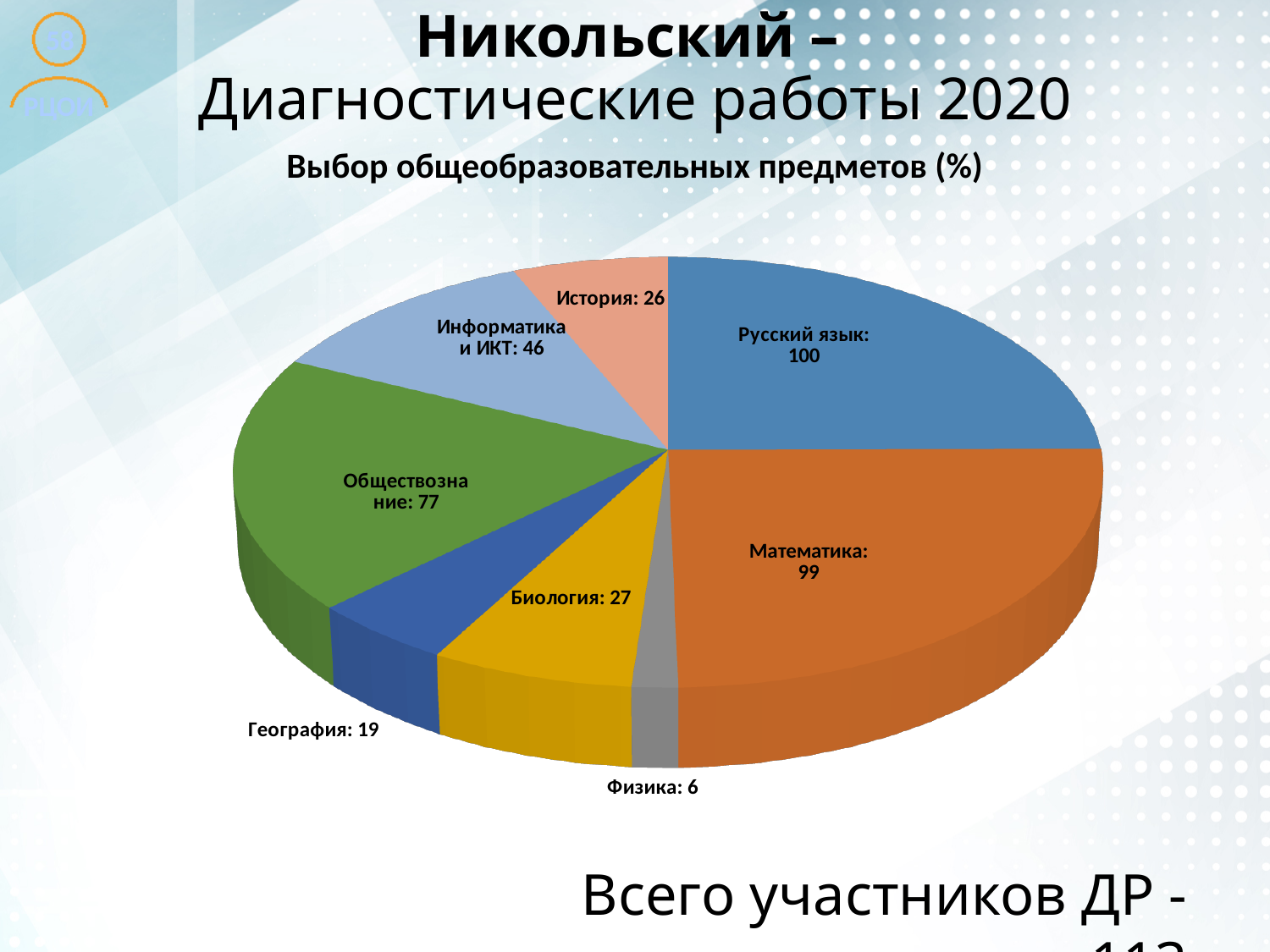
How many subjects (slices) are shown in the pie chart? 8 What is the value for Русский язык? 100 Which subject has the lowest value? Физика What is the value for Физика? 6 What is the value for Информатика и ИКТ? 46 What is the value for Математика? 99 Which is larger, the value for Биология or the value for География? Биология What is the title of the chart? Выбор общеобразовательных предметов (%) What kind of chart is shown on the slide? pie chart What is the difference between the values for Обществознание and Информатика и ИКТ? 31 Which subject has the highest value? Русский язык What is the value for Обществознание? 77